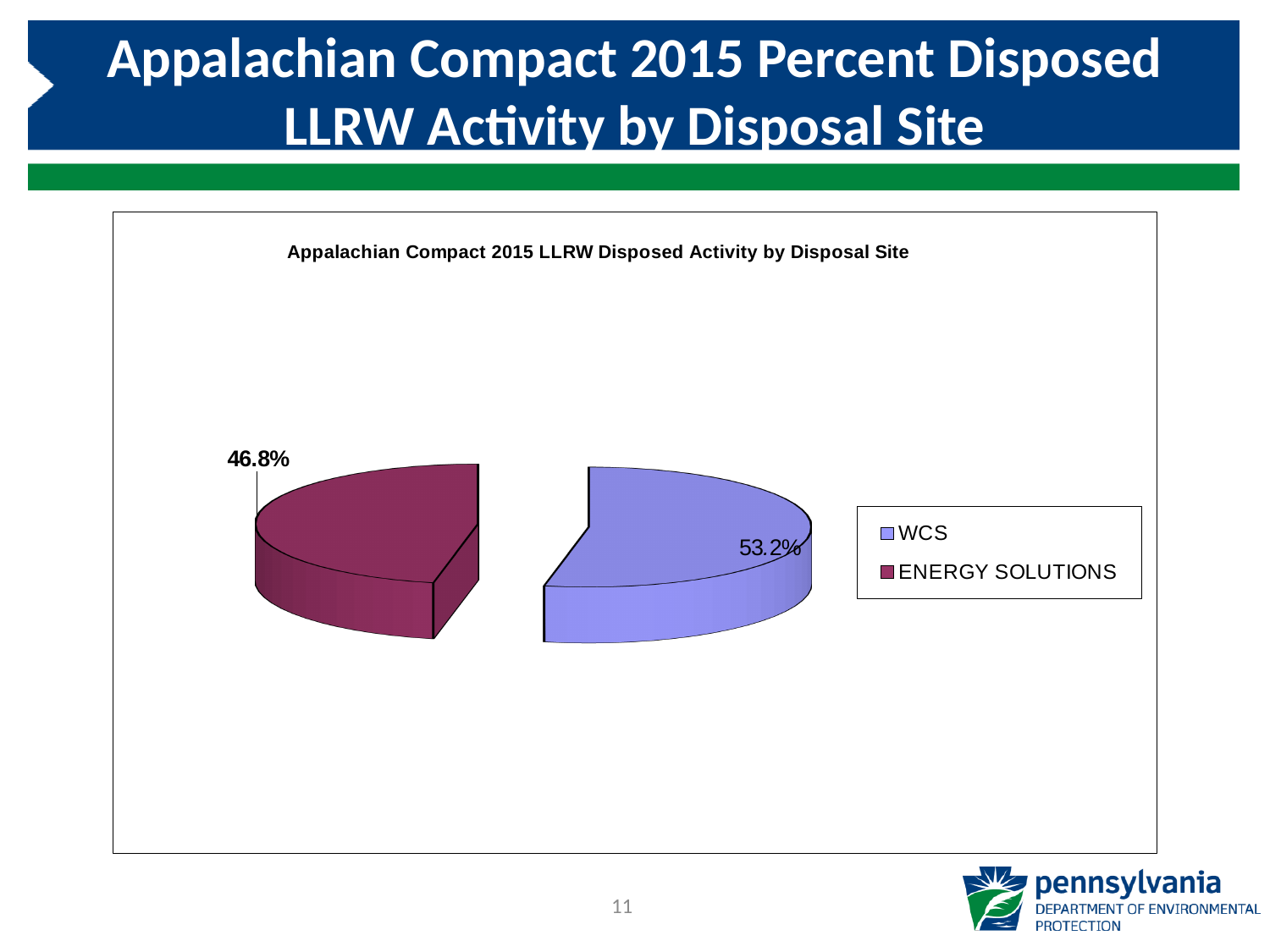
What share of the pie does WCS have? 53.2% Which disposal site has the smallest share? ENERGY SOLUTIONS Which is larger, the share for WCS or the share for ENERGY SOLUTIONS? WCS What share of the pie does ENERGY SOLUTIONS have? 46.8% What is the difference in percentage points between the WCS share and the ENERGY SOLUTIONS share? 6.4 What is the chart's title? Appalachian Compact 2015 LLRW Disposed Activity by Disposal Site How many entries does the legend list? 2 How many slices does the pie chart have? 2 What kind of chart is shown on the slide? pie chart Which colour represents ENERGY SOLUTIONS in the chart? maroon Which disposal site has the largest share? WCS